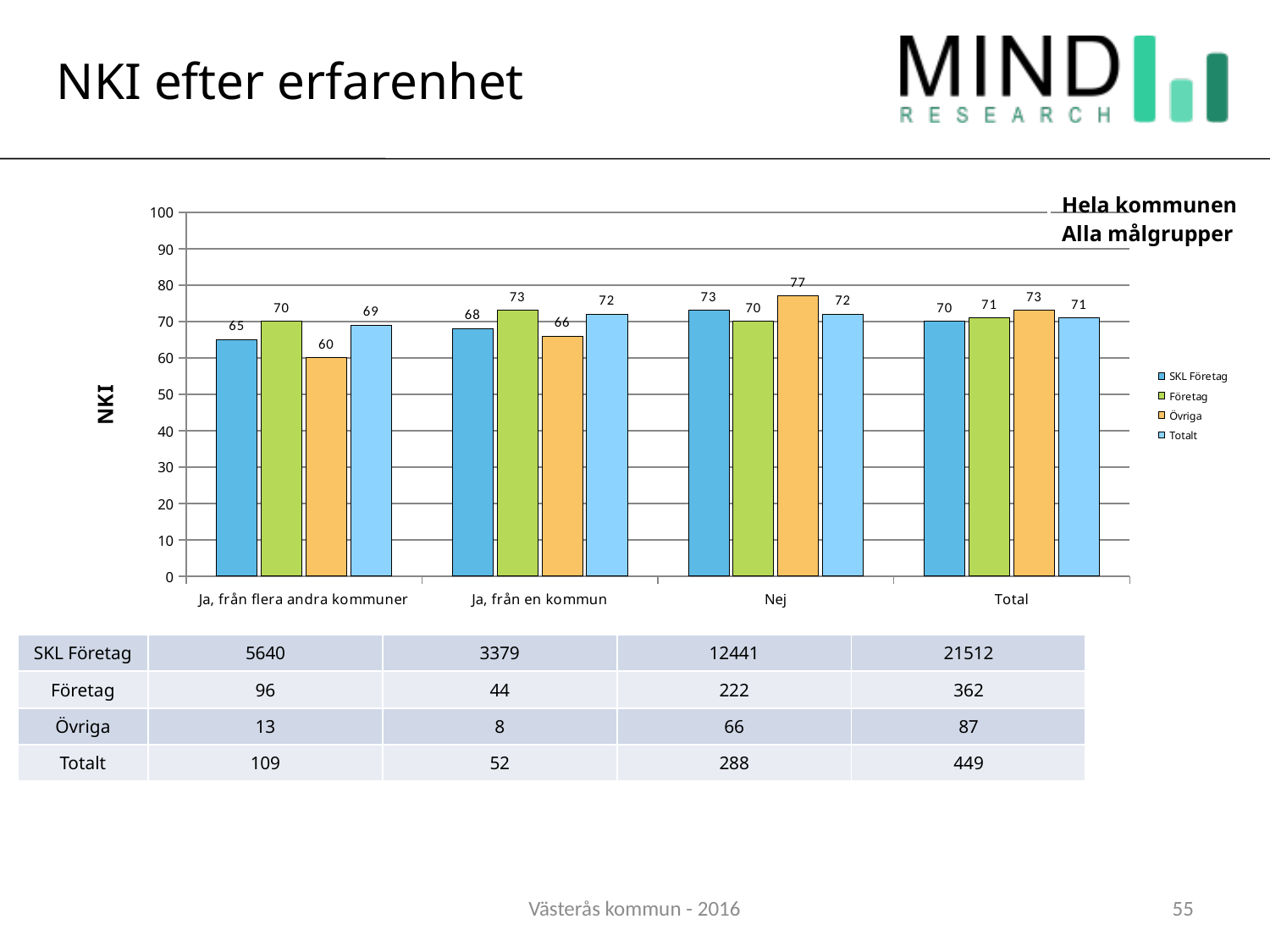
What is the NKI value for Övriga in the category 'Ja, från flera andra kommuner'? 60 Which is larger: the SKL Företag value for 'Nej' or the SKL Företag value for 'Ja, från flera andra kommuner'? Nej What is the difference between the Övriga value for 'Nej' and the Övriga value for 'Ja, från flera andra kommuner'? 17 What is the NKI value for Företag in the category 'Ja, från en kommun'? 73 How many series does the chart legend list? 4 What is the NKI value for Övriga in the category 'Nej'? 77 What is the NKI value for SKL Företag in the category 'Total'? 70 What is the label of the y axis of the chart? NKI What type of chart is shown on the slide? Bar chart Which series has the highest NKI value in the category 'Nej'? Övriga Which series has the lowest NKI value in the category 'Ja, från flera andra kommuner'? Övriga How many categories are shown on the x axis of the chart? 4